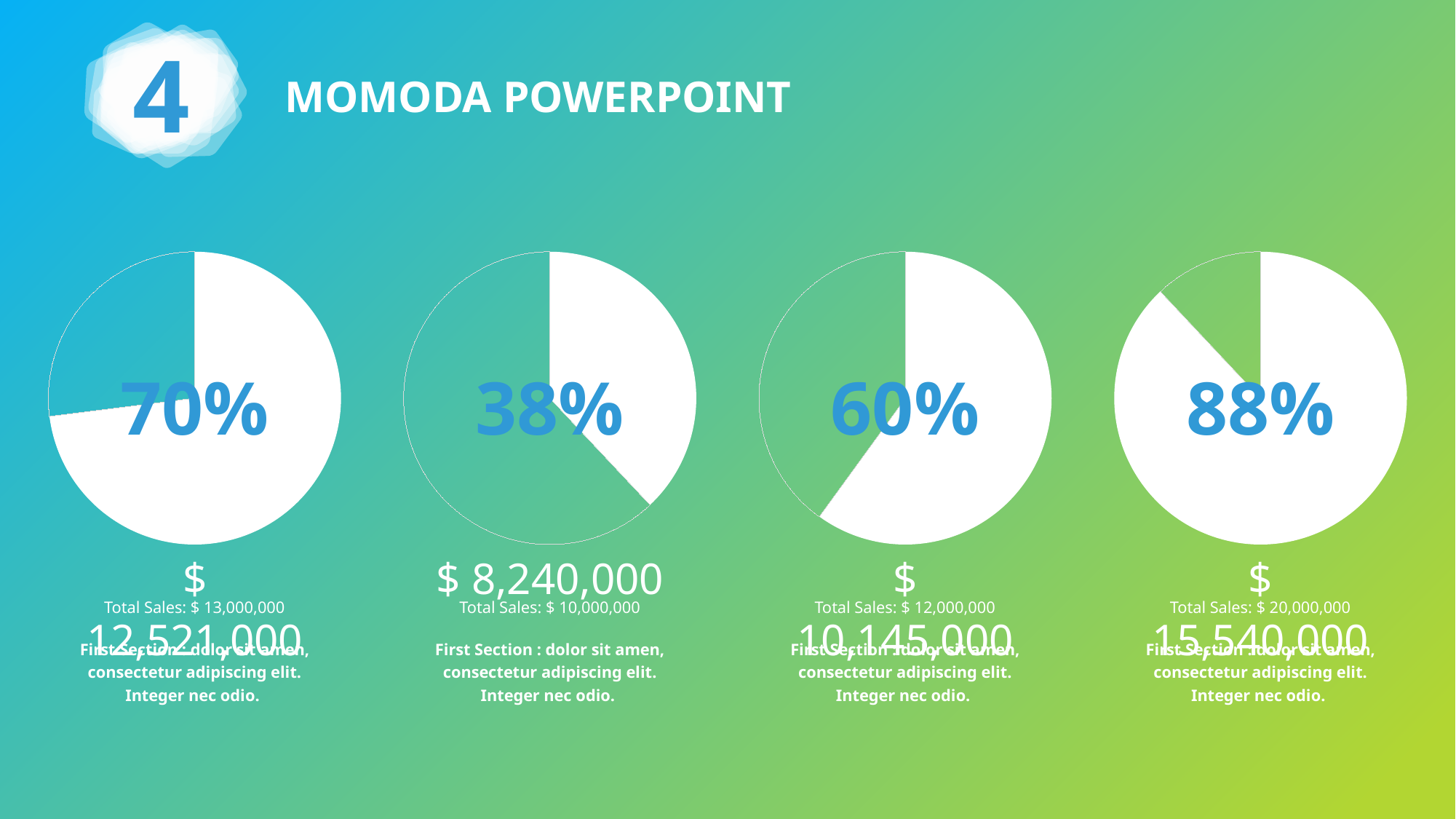
What is the difference in percentage points between the rightmost pie chart and the second pie chart from the left? 50 percentage points What kind of charts are shown on the slide? Pie charts What is the Total Sales figure printed under the rightmost pie chart? $ 20,000,000 How many pie charts are on the slide? 4 What percentage is shown on the leftmost pie chart? 70% What percentage is shown on the second pie chart from the left? 38% What percentage is shown on the third pie chart from the left? 60% Which pie chart shows the highest percentage? The rightmost chart (88%) What percentage is shown on the rightmost pie chart? 88% Which pie chart shows the lowest percentage? The second chart from the left (38%) What is the title of the slide? MOMODA POWERPOINT Which shows a larger percentage, the leftmost pie chart or the third pie chart from the left? The leftmost chart (70%)